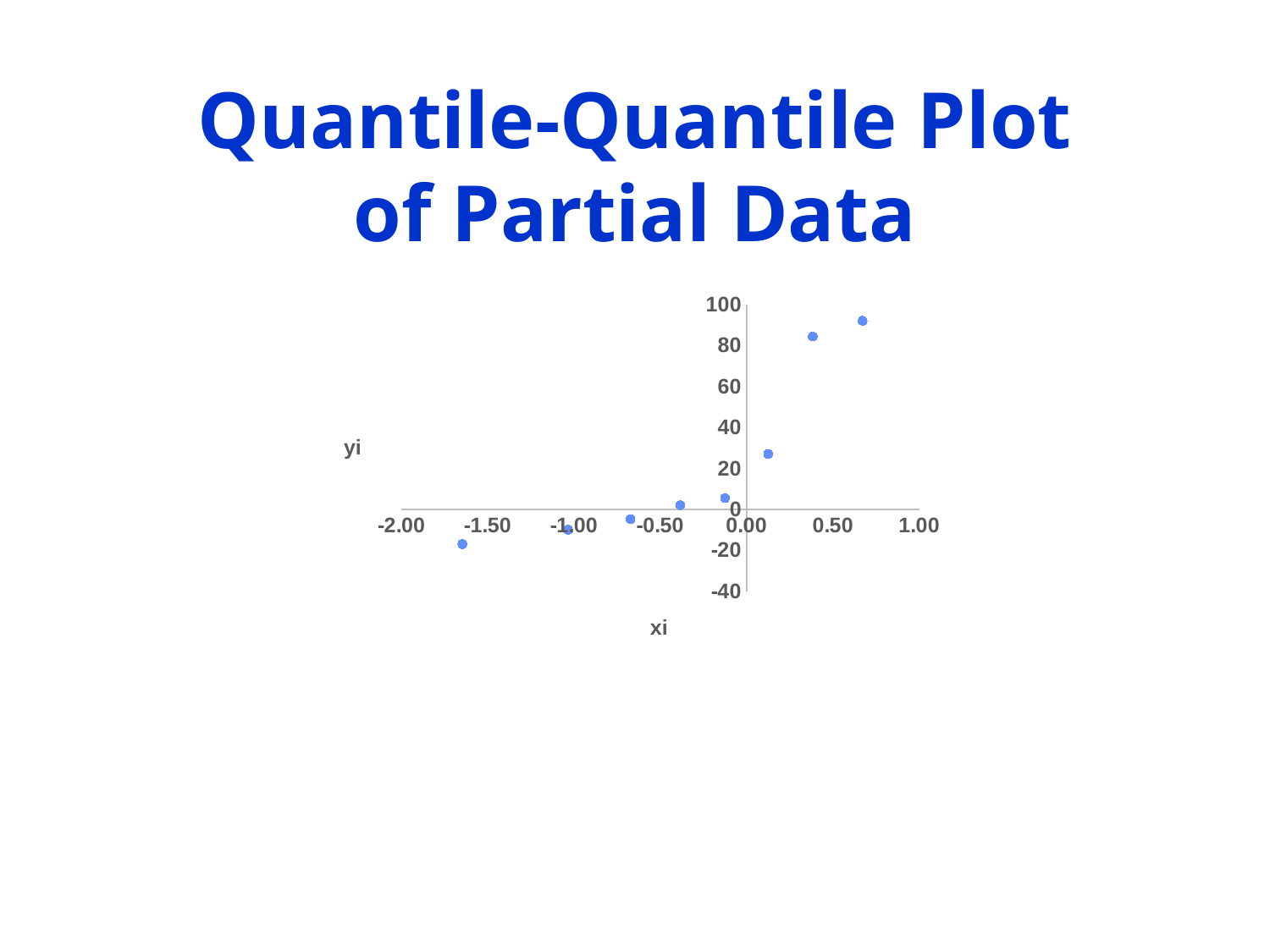
How many data points are plotted on the chart? 8 Is the yi value of the leftmost point (near xi = -1.65) greater or less than 0? less What is the title of the slide containing the chart? Quantile-Quantile Plot of Partial Data Which point has the lowest yi value on the chart? The leftmost point (near xi = -1.65) Is the yi value of the rightmost point (near xi = 0.70) greater or less than 80? greater Do the yi values generally rise or fall as xi increases along the x axis? Rise Is the yi value of the point near xi = 0.40 greater or less than 60? greater What is the label of the horizontal axis? xi Which has the larger yi value: the point near xi = 0.40 or the point near xi = 0.10? The point near xi = 0.40 Which point has the highest yi value: the leftmost point or the rightmost point? The rightmost point What kind of chart is shown on the slide? Scatter plot